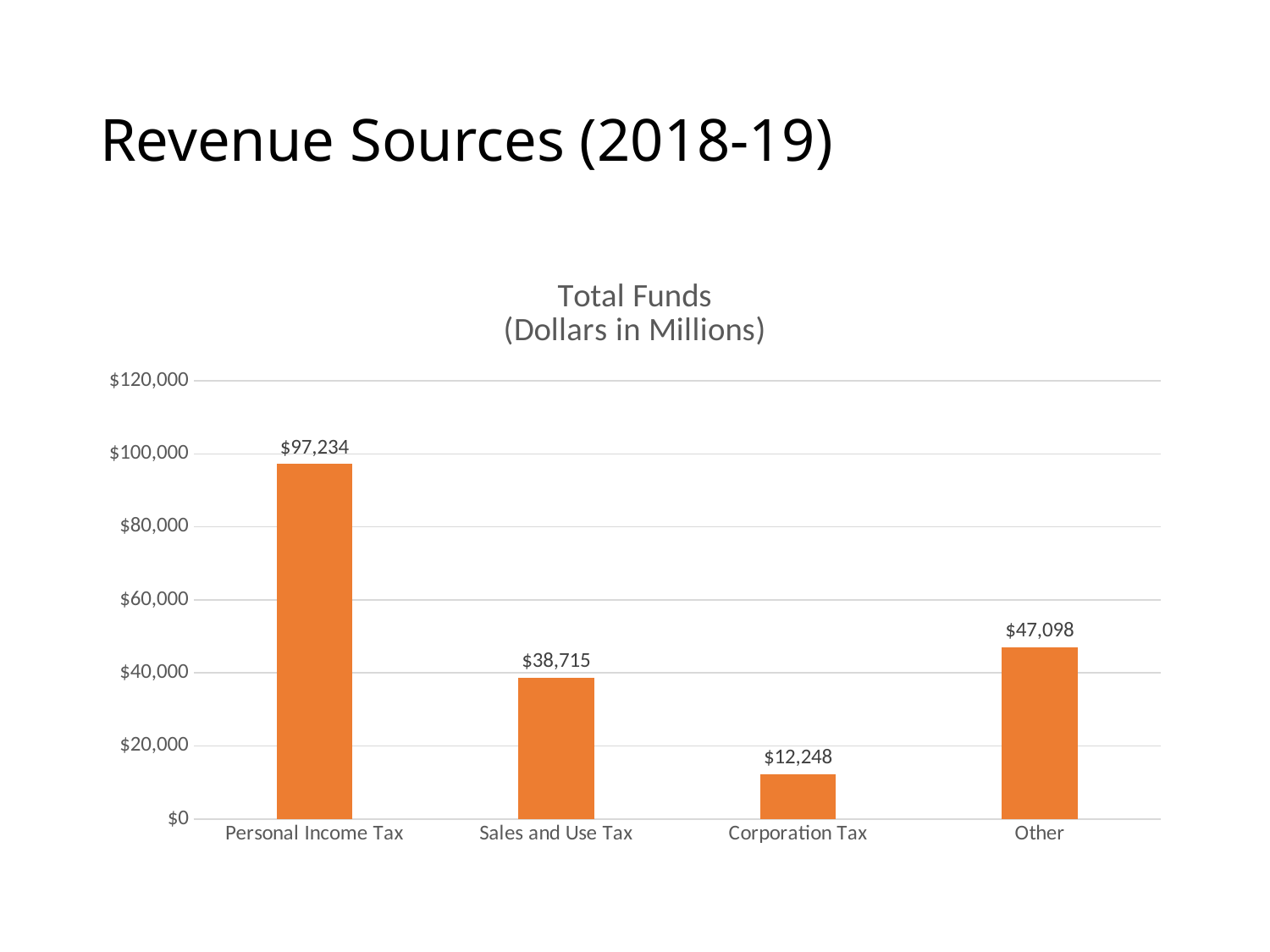
How many categories are shown in the chart? 4 Which is larger, Sales and Use Tax or Other? Other What is the difference between Other and Corporation Tax? $34,850 Which category has the lowest value? Corporation Tax What is the value for Personal Income Tax? $97,234 What is the value for Other? $47,098 What kind of chart is shown on the slide? Bar chart What is the title of the chart? Total Funds (Dollars in Millions) Which category has the highest value? Personal Income Tax What is the difference between Personal Income Tax and Sales and Use Tax? $58,519 What is the value for Sales and Use Tax? $38,715 What is the value for Corporation Tax? $12,248